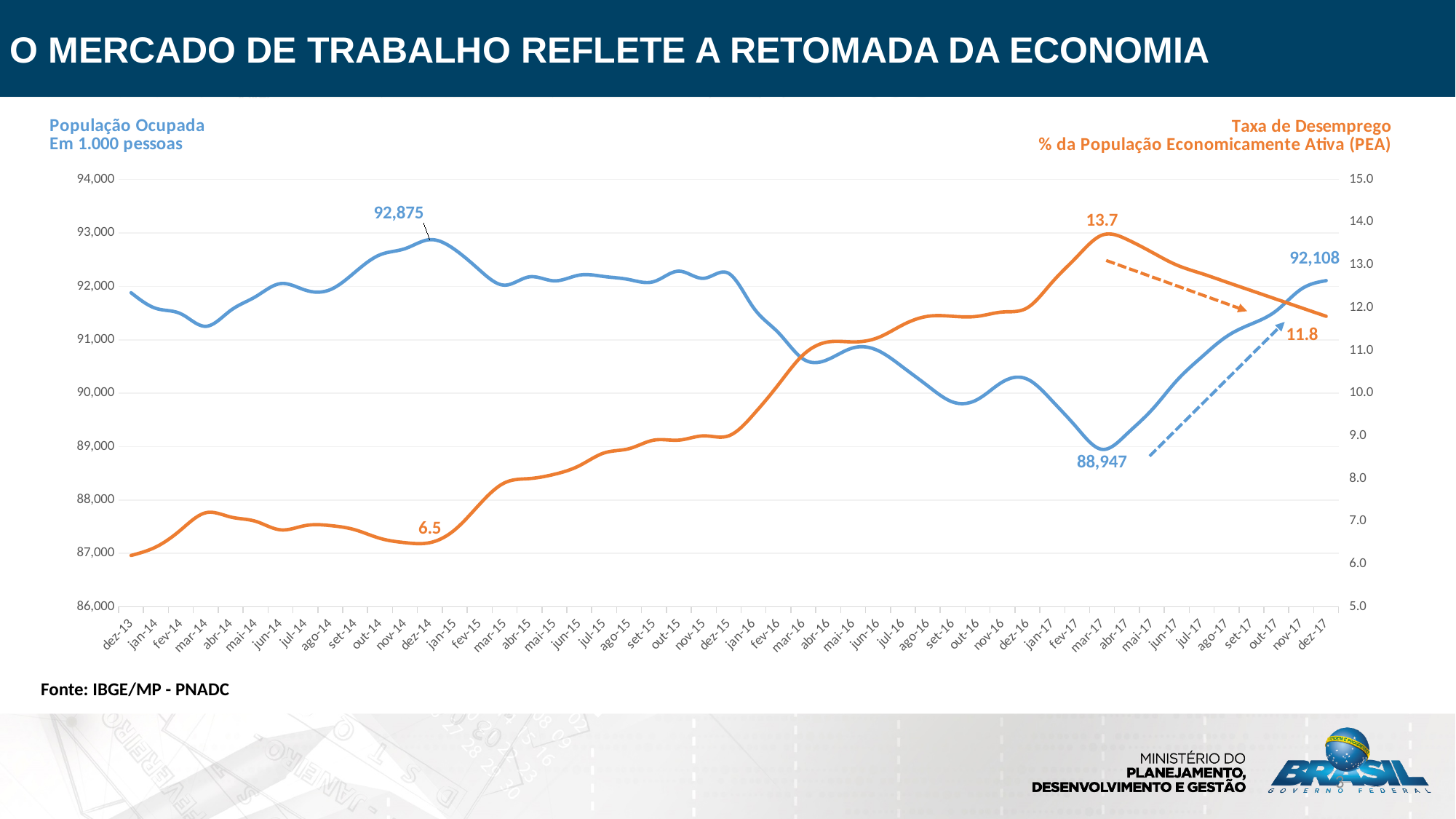
What is the value of População Ocupada in mar-17? 88,947 In which month does the População Ocupada line reach its lowest point? mar-17 In which month does the Taxa de Desemprego line reach its highest point? mar-17 What is the source cited for the chart? IBGE/MP - PNADC What is the value of População Ocupada in dez-14? 92,875 By how much did the Taxa de Desemprego fall from mar-17 to dez-17? 1.9 Is the Taxa de Desemprego in dez-13 greater or less than 7.0? less What kind of chart is shown on the slide? line chart What is the difference between the População Ocupada in dez-14 and in mar-17? 3,928 What is the Taxa de Desemprego in dez-17? 11.8 What is the Taxa de Desemprego in dez-14? 6.5 What is the Taxa de Desemprego in mar-17? 13.7